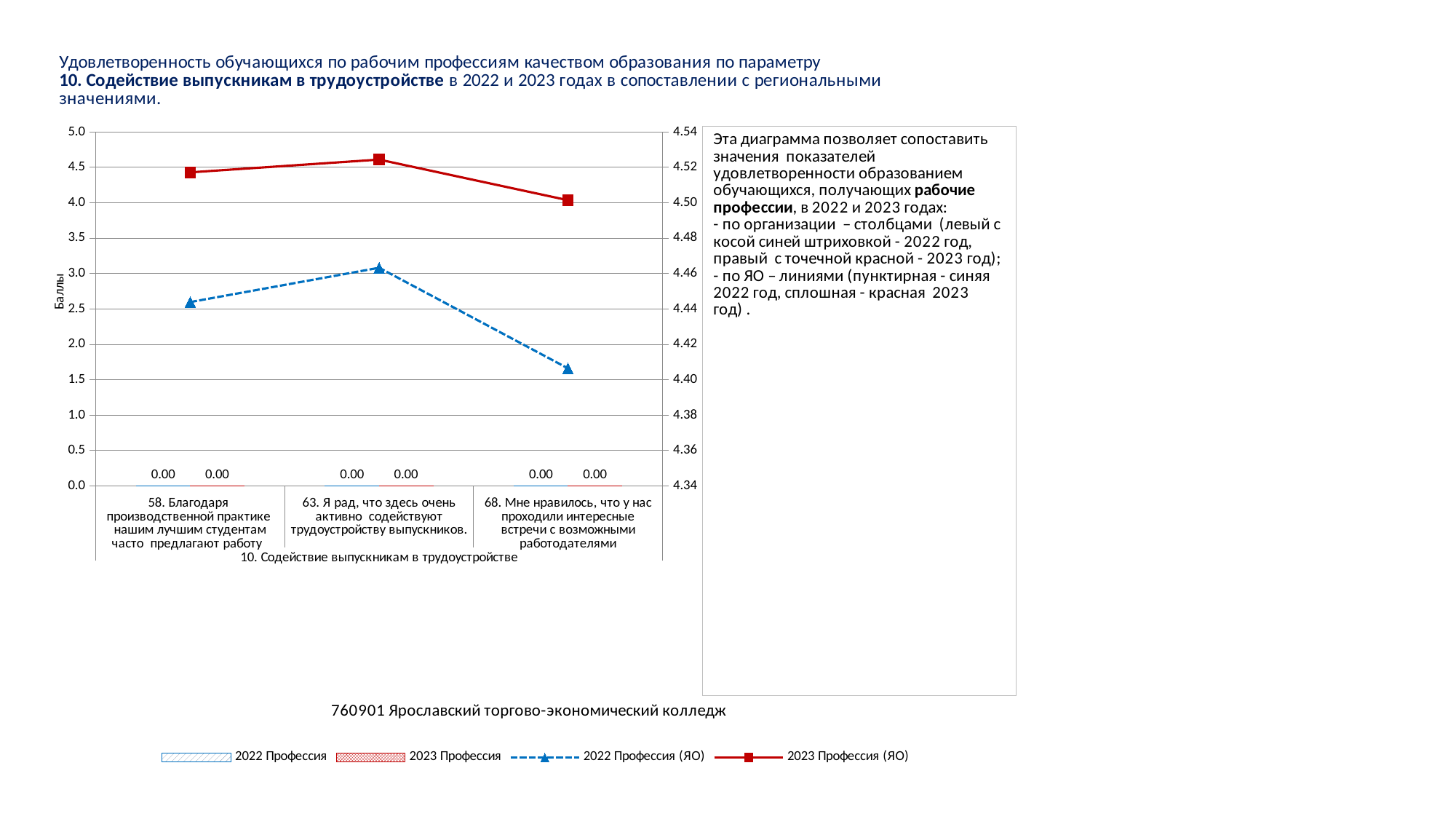
At category 68, which series is higher: 2022 Профессия (ЯО) or 2023 Профессия (ЯО)? 2023 Профессия (ЯО) For which category is the 2023 Профессия (ЯО) line at its lowest? 68. Мне нравилось, что у нас проходили интересные встречи с возможными работодателями What kind of chart is used for the 2023 Профессия (ЯО) series? line chart What is the value of the 2023 Профессия bar for category 63 (Я рад, что здесь очень активно содействуют трудоустройству выпускников)? 0.00 What is the title of the left vertical axis? Баллы On the right-hand axis, is the 2023 Профессия (ЯО) value for category 58 greater or less than 4.50? greater How many series does the chart legend list? 4 How many categories are shown on the x axis of the chart? 3 For which category is the 2022 Профессия (ЯО) line at its highest? 63. Я рад, что здесь очень активно содействуют трудоустройству выпускников. On the right-hand axis, is the 2022 Профессия (ЯО) value for category 68 greater or less than 4.42? less What is the value of the 2022 Профессия bar for category 58 (Благодаря производственной практике нашим лучшим студентам часто предлагают работу)? 0.00 Does the 2022 Профессия (ЯО) line rise or fall from category 63 to category 68? fall